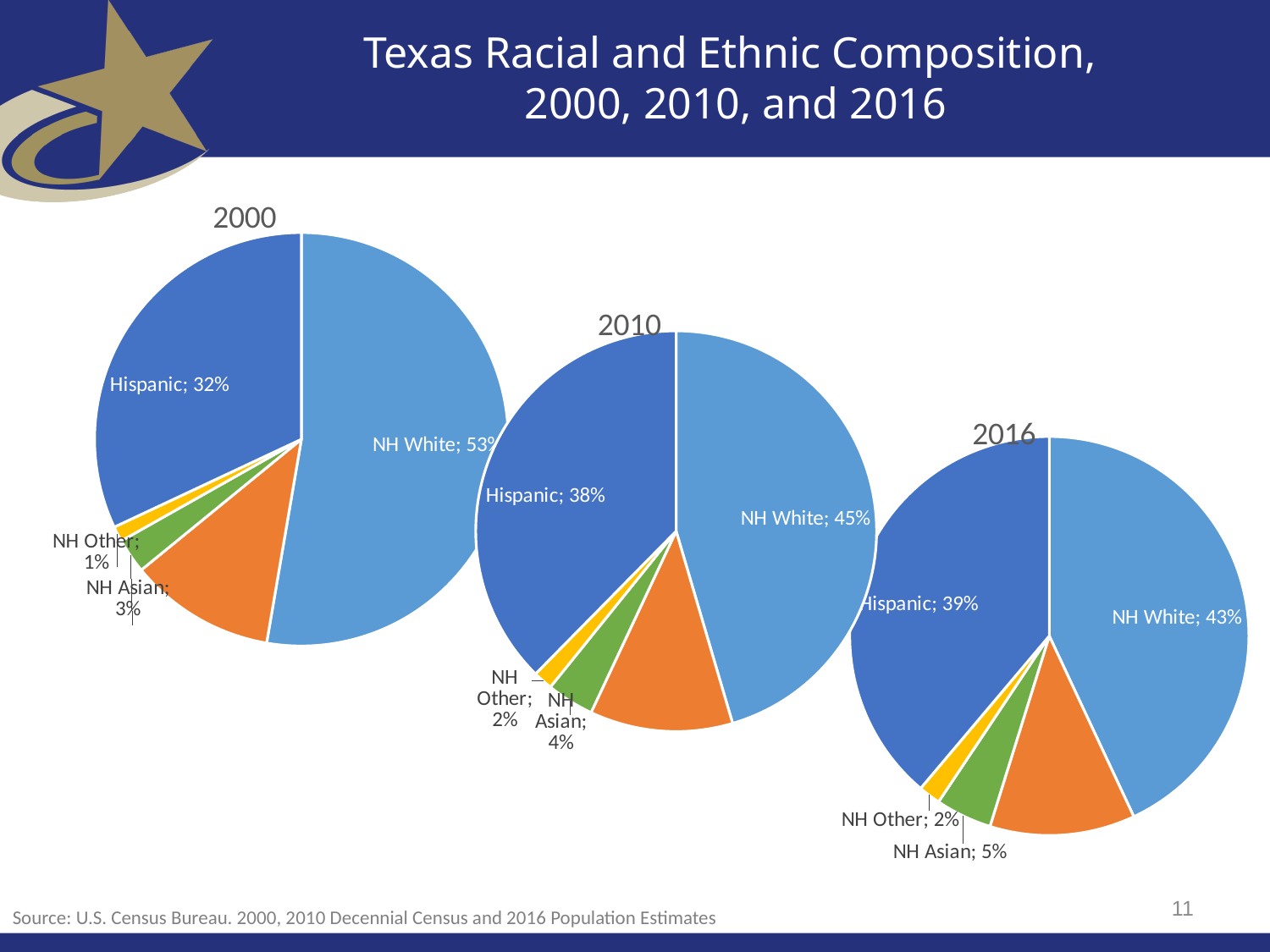
In the 2010 pie chart, what share is Hispanic? 38% What is the difference between the NH White share in 2000 and in 2016? 10 percentage points In the 2016 pie chart, which is larger, the NH White share or the Hispanic share? NH White In the 2010 pie chart, which labeled category has the smallest share? NH Other In the 2000 pie chart, what share is NH White? 53% In the 2016 pie chart, what share is NH Asian? 5% What kind of charts are shown on the slide? Pie charts In the 2016 pie chart, what share is NH Other? 2% Across the 2000, 2010, and 2016 pie charts, does the Hispanic share rise or fall over time? Rise What is the title of the slide? Texas Racial and Ethnic Composition, 2000, 2010, and 2016 How many slices does the 2010 pie chart have? 5 In the 2000 pie chart, which labeled category has the largest share? NH White